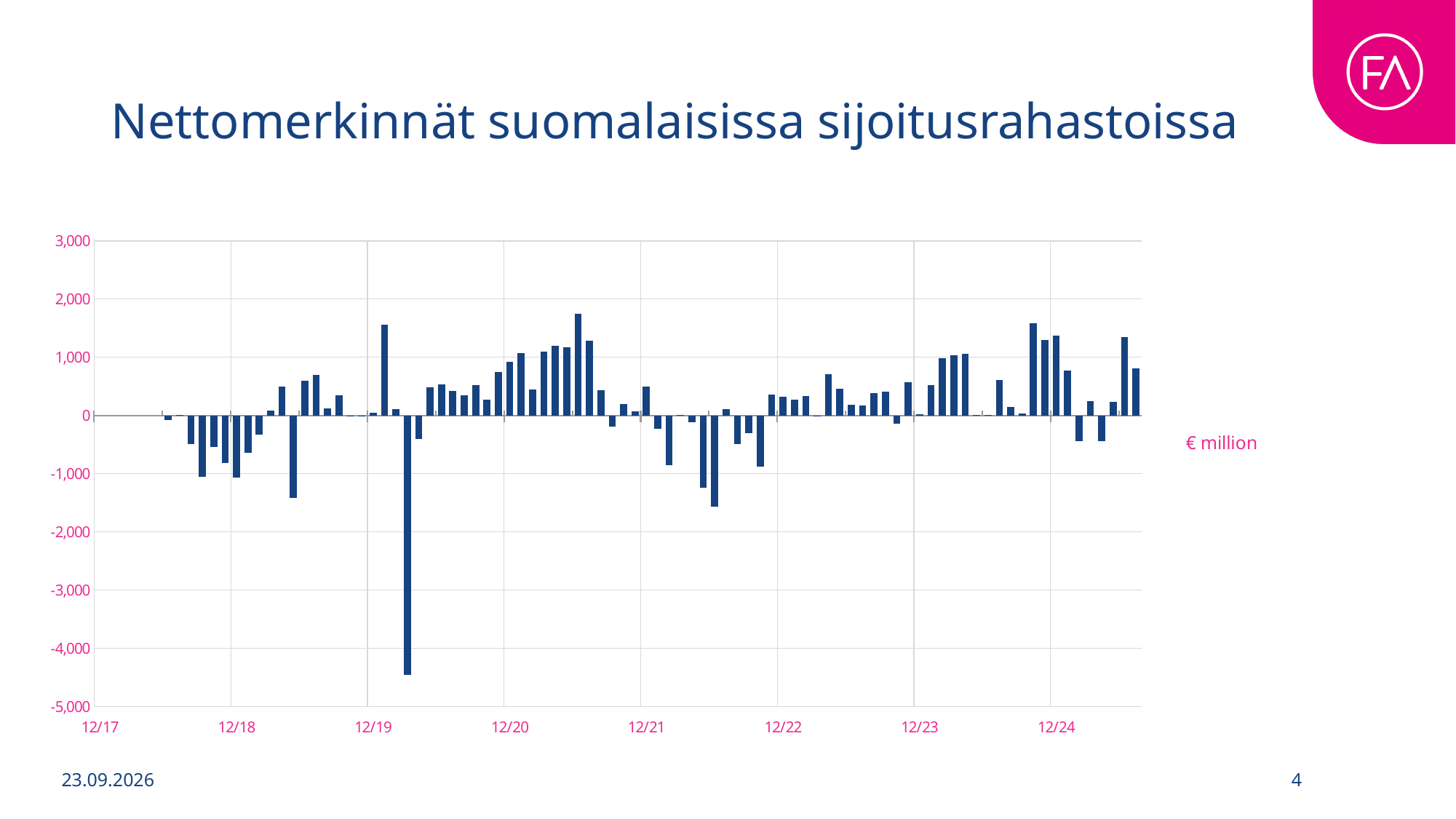
What is the title of the chart? Nettomerkinnät suomalaisissa sijoitusrahastoissa Which is larger in absolute size, the largest positive bar or the largest negative bar? the largest negative bar What kind of chart is shown on the slide? bar chart Are most of the bars between 12/20 and 12/21 positive or negative? positive Is the highest bar in the chart greater or less than 2,000? less What unit is indicated next to the chart? € million Between which two x-axis labels does the lowest bar occur? between 12/19 and 12/20 Is the lowest bar in the chart greater or less than -4,000? less How many date labels are shown on the x axis? 8 Are most of the bars between 12/17 and 12/18 positive or negative? negative Is the lowest bar in the chart greater or less than -3,000? less